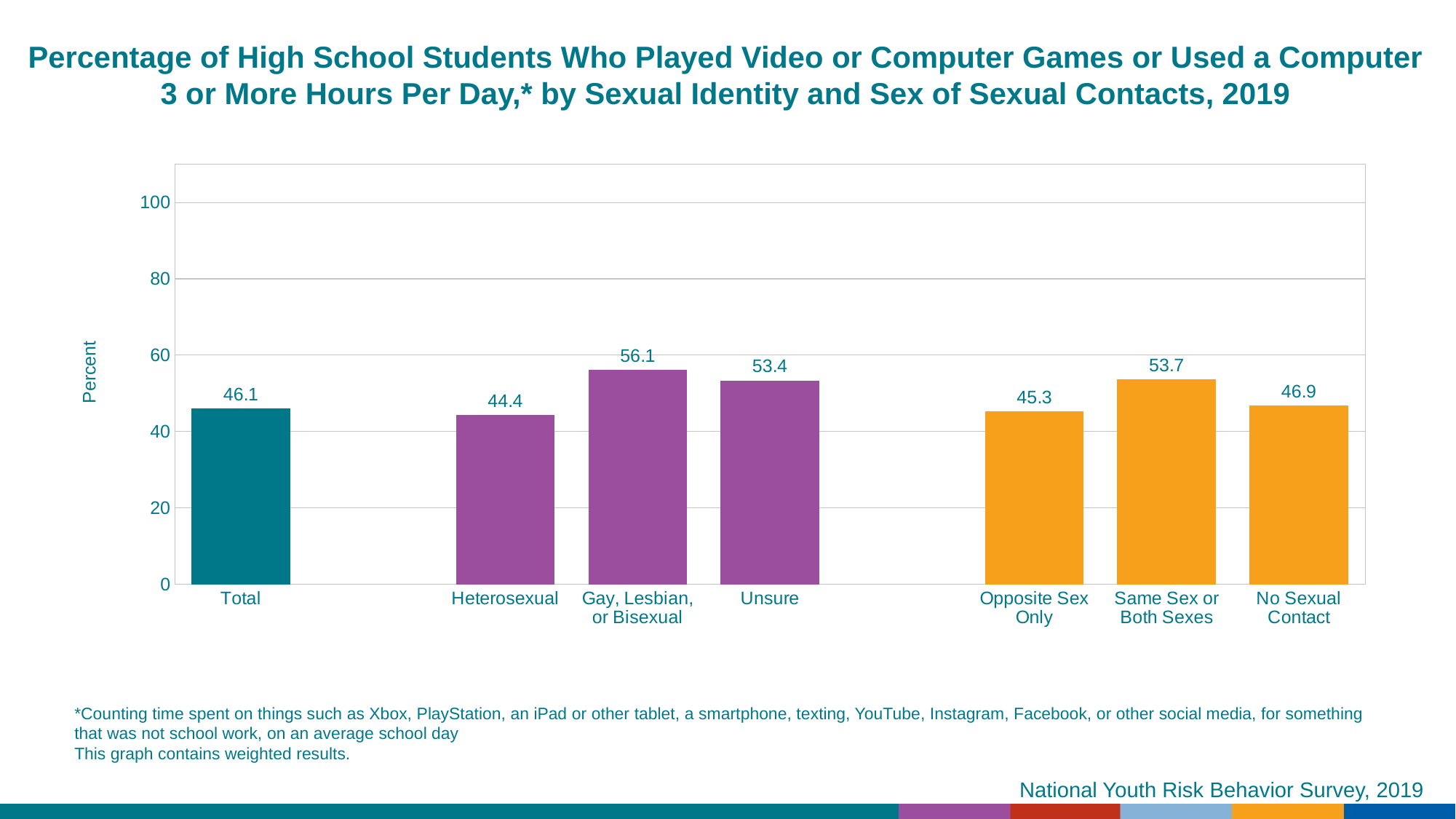
What is the value for Gay, Lesbian, or Bisexual students? 56.1 What is the value for Same Sex or Both Sexes? 53.7 What kind of chart is shown on the slide? Bar chart Is the value for Same Sex or Both Sexes greater or less than 40? greater What is the label of the y axis? Percent How many bars are shown in the chart? 7 What is the value for No Sexual Contact? 46.9 Which is larger, the value for Unsure or the value for Opposite Sex Only? Unsure What is the value for Total? 46.1 Which category has the lowest value? Heterosexual What is the difference between the values for Gay, Lesbian, or Bisexual and Heterosexual? 11.7 Which category has the highest value? Gay, Lesbian, or Bisexual